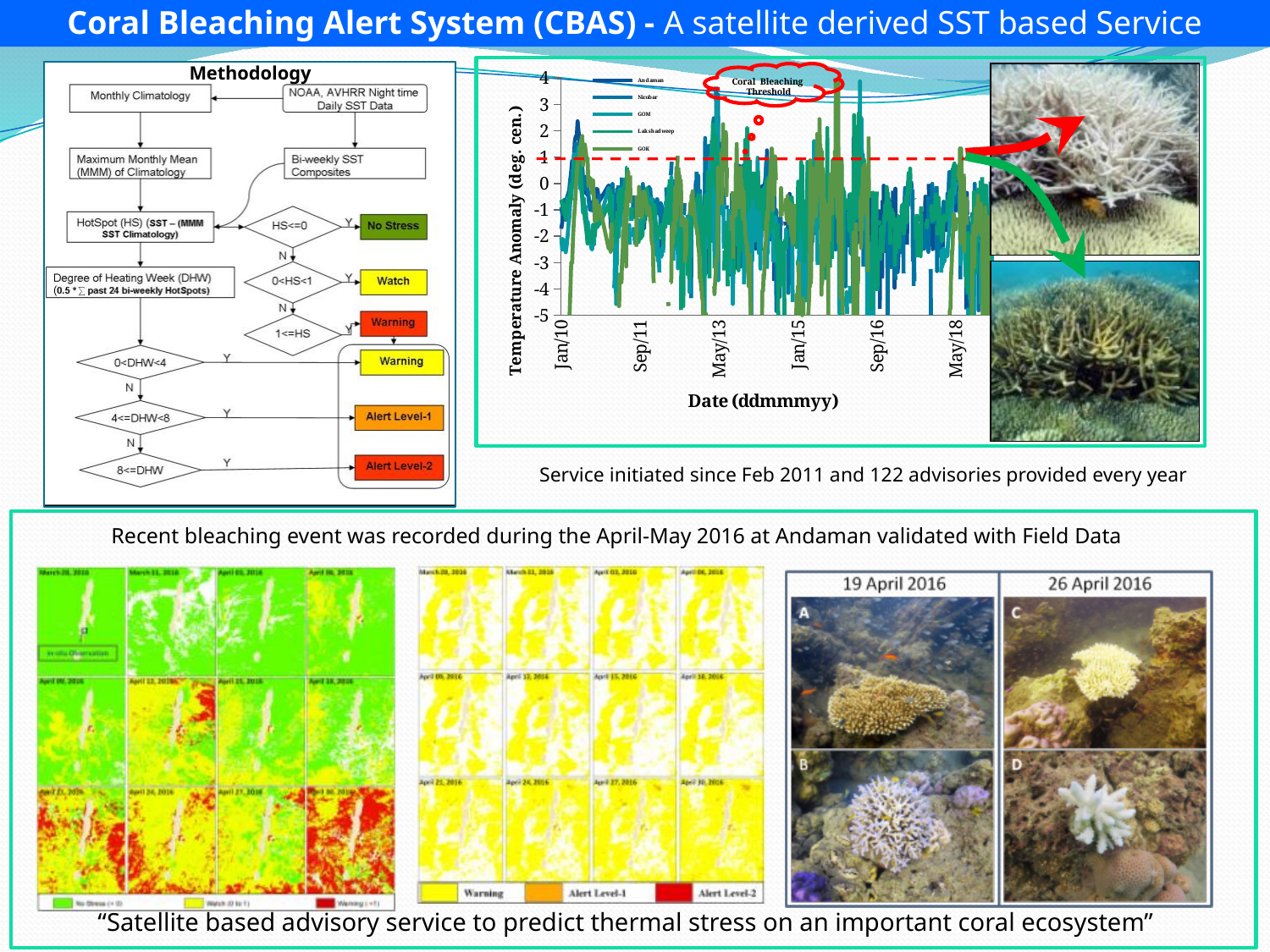
What is the first date tick label on the x-axis of the temperature anomaly chart? Jan/10 What is the x-axis label of the temperature anomaly chart? Date (ddmmmyy) What is the last date tick label on the x-axis of the temperature anomaly chart? May/18 What is the lowest value shown on the y-axis of the temperature anomaly chart? -5 What kind of chart is the temperature anomaly chart on the slide? line chart What is the y-axis label of the temperature anomaly chart? Temperature Anomaly (deg. cen.) How many series does the legend of the temperature anomaly chart list? 5 What is the highest value shown on the y-axis of the temperature anomaly chart? 4 Which series is listed last in the legend of the temperature anomaly chart? GOK At what temperature anomaly value is the Coral Bleaching Threshold dashed line drawn on the chart? 1 Which series is listed first in the legend of the temperature anomaly chart? Andaman How many date tick labels are shown on the x-axis of the temperature anomaly chart? 6